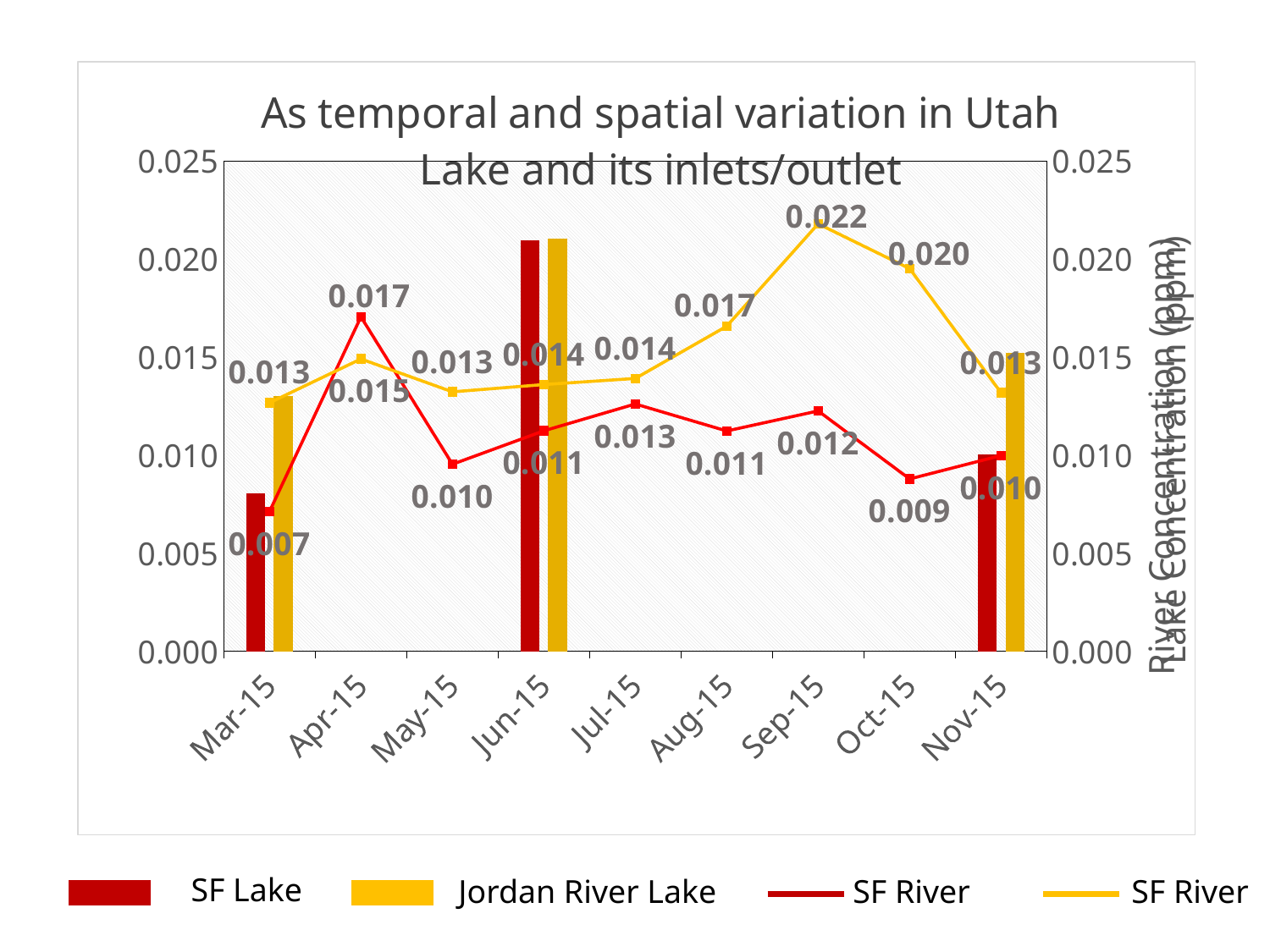
At Aug-15, which is larger: the value of the yellow line or the value of the red line? The yellow line In which month does the red line have its lowest value? Mar-15 What kind of chart is shown on the slide? A combined bar and line chart Does the yellow line rise or fall from Jul-15 to Sep-15? Rises What is the value of the yellow line at Sep-15? 0.022 What is the difference between the yellow line's values at Sep-15 and Oct-15? 0.002 In which month does the yellow line reach its highest value? Sep-15 What is the value of the red line at Oct-15? 0.009 How many series does the chart's legend list? 4 What is the value of the red line at Apr-15? 0.017 Is the Jordan River Lake bar at Mar-15 greater or less than 0.010? greater How many months are shown along the x axis of the chart? 9